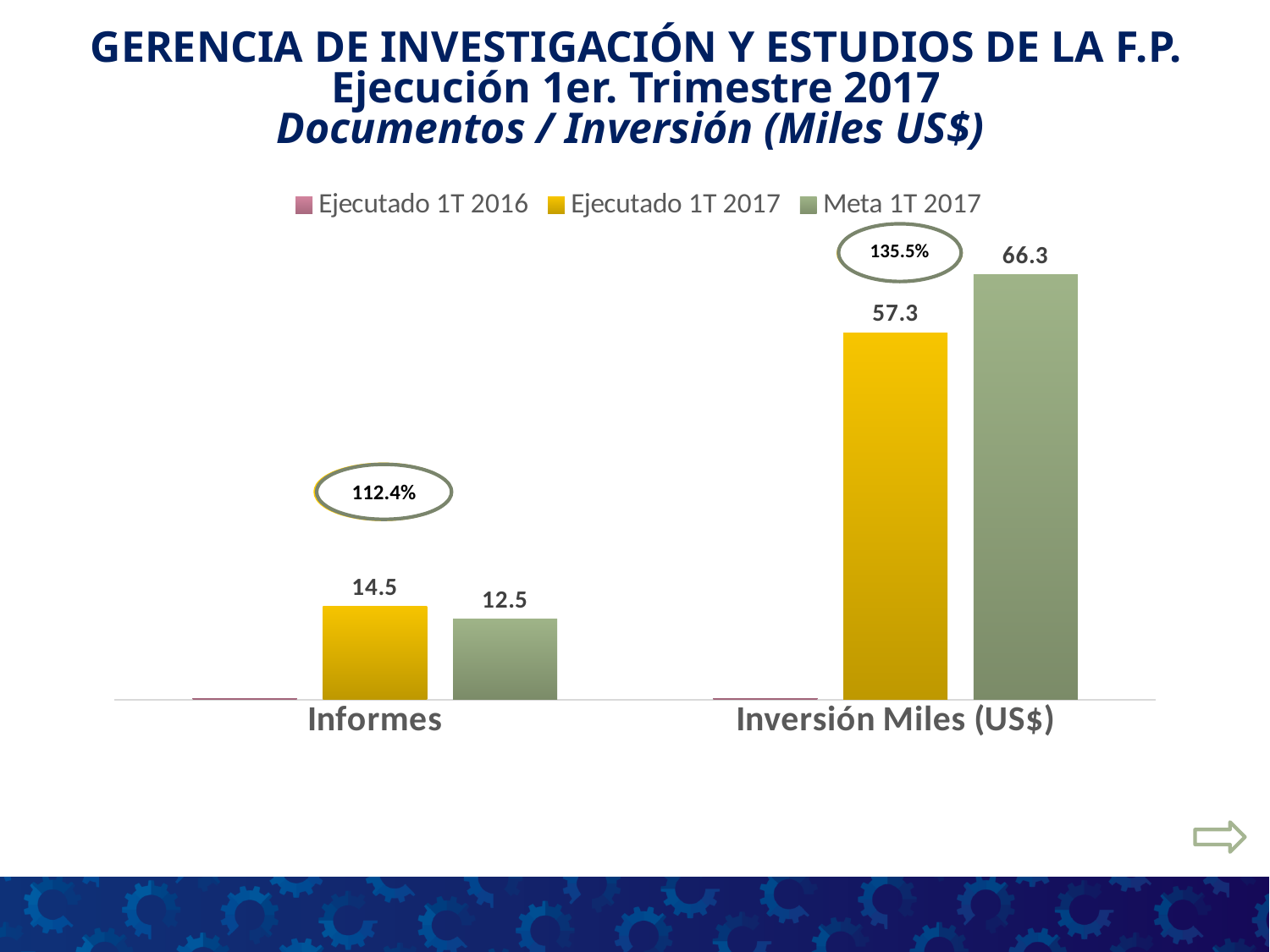
For Inversión Miles (US$), which is larger: Ejecutado 1T 2017 or Meta 1T 2017? Meta 1T 2017 What is the Meta 1T 2017 value for Informes? 12.5 What kind of chart is shown on the slide? Bar chart What percentage is shown in the oval above the Informes bars? 112.4% What is the Ejecutado 1T 2017 value for Informes? 14.5 What is the Meta 1T 2017 value for Inversión Miles (US$)? 66.3 What is the difference between the Meta 1T 2017 and Ejecutado 1T 2017 values for Inversión Miles (US$)? 9.0 What percentage is shown in the oval above the Inversión Miles (US$) bars? 135.5% What is the Ejecutado 1T 2017 value for Inversión Miles (US$)? 57.3 How many series does the legend list? 3 What is the difference between the Ejecutado 1T 2017 and Meta 1T 2017 values for Informes? 2.0 For Informes, which is larger: Ejecutado 1T 2017 or Meta 1T 2017? Ejecutado 1T 2017